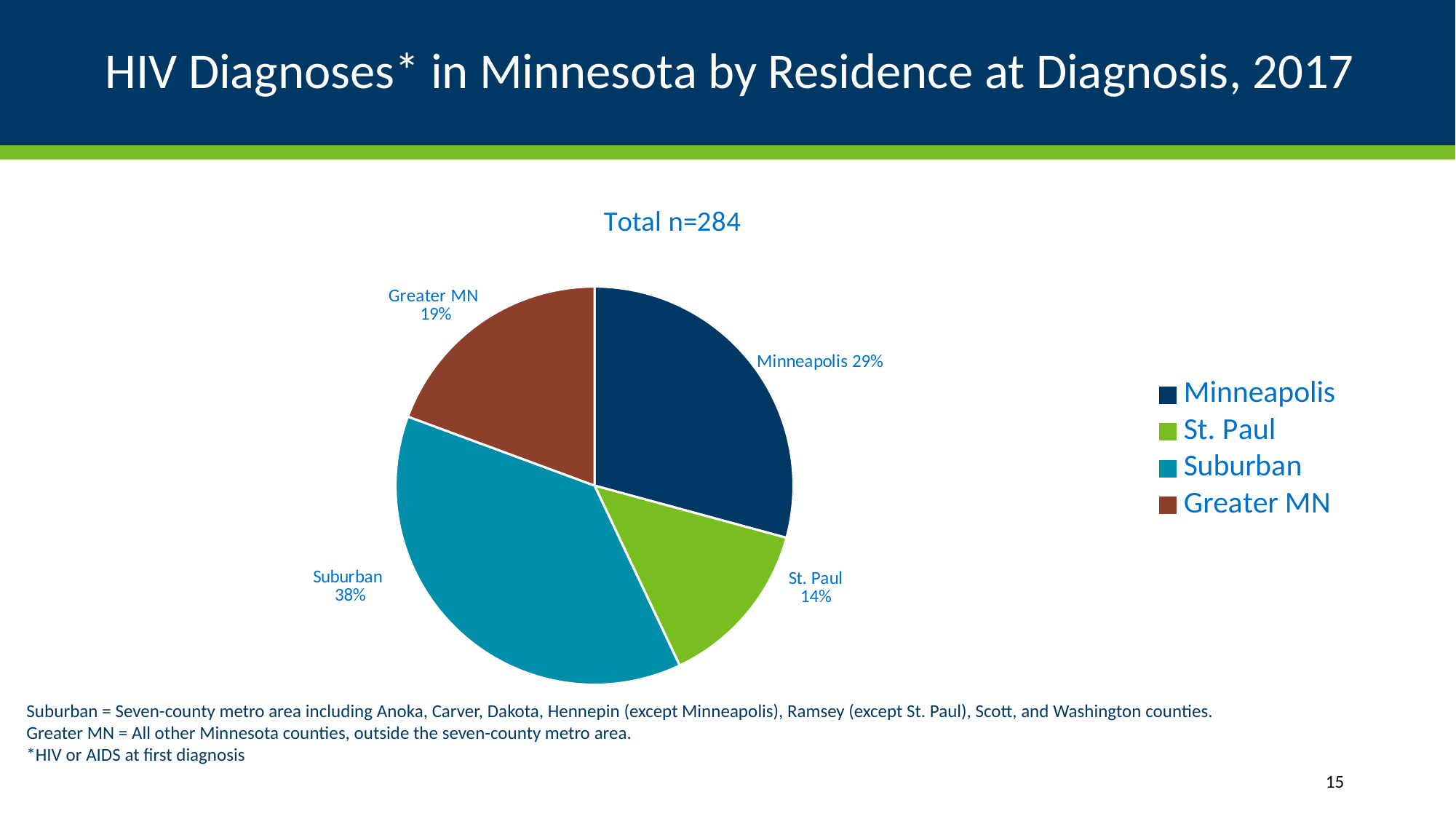
What is the total number of HIV diagnoses (n) shown above the chart? 284 What colour represents the Suburban slice in the pie chart? Teal (blue-green) How many residence categories are shown in the pie chart? 4 Which has a larger share of HIV diagnoses, Greater MN or St. Paul? Greater MN Which residence category has the largest share of HIV diagnoses? Suburban Which residence category has the smallest share of HIV diagnoses? St. Paul What share of HIV diagnoses is attributed to Minneapolis? 29% What share of HIV diagnoses is attributed to Greater MN? 19% What share of HIV diagnoses is attributed to Suburban residence? 38% What type of chart is shown on the slide? Pie chart What share of HIV diagnoses is attributed to St. Paul? 14% What is the difference in percentage points between the Suburban and Minneapolis shares? 9 percentage points